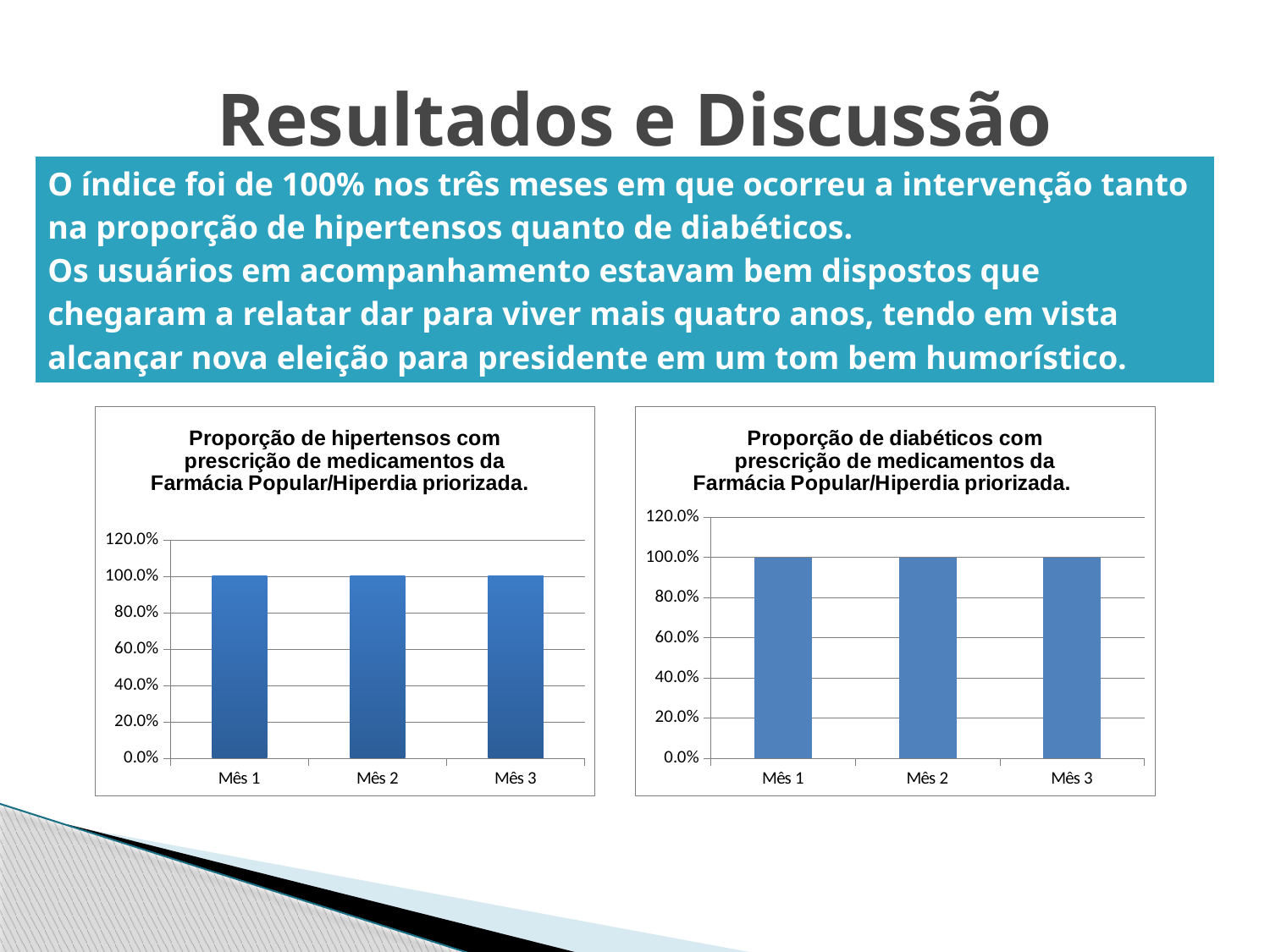
In the left chart (Proporção de hipertensos), what is the value for Mês 2? 100.0% How many categories are shown on the x axis of the left chart (Proporção de hipertensos)? 3 In the left chart (Proporção de hipertensos), what is the value for Mês 1? 100.0% What kind of chart is the right chart (Proporção de diabéticos)? Bar chart In the left chart (Proporção de hipertensos), do the values rise, fall or stay the same from Mês 1 to Mês 3? Stay the same In the left chart (Proporção de hipertensos), what is the difference between the values for Mês 1 and Mês 3? 0.0% In the right chart (Proporção de diabéticos), what is the value for Mês 1? 100.0% How many bars are plotted in the right chart (Proporção de diabéticos)? 3 In the right chart (Proporção de diabéticos), what is the value for Mês 3? 100.0% What is the highest tick shown on the y axis of the right chart (Proporção de diabéticos)? 120.0% In the right chart (Proporção de diabéticos), is the value for Mês 2 greater or less than 80.0%? greater What kind of chart is the left chart (Proporção de hipertensos)? Bar chart